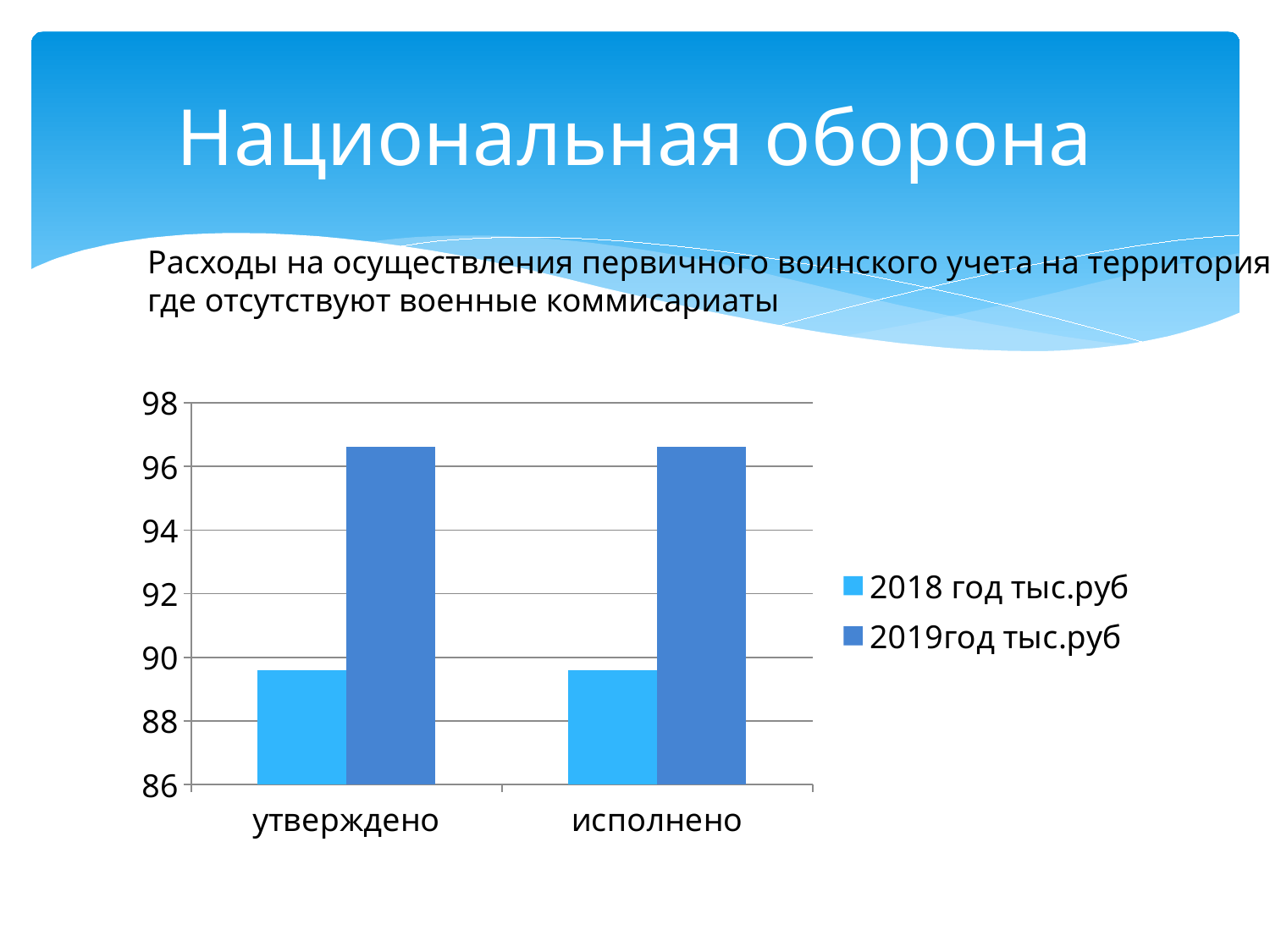
Is the value for 2019год тыс.руб in the category исполнено greater or less than 98? less What kind of chart is shown on the slide? bar chart What are the two series listed in the chart's legend? 2018 год тыс.руб and 2019год тыс.руб Which series is shown in the darker blue bars? 2019год тыс.руб Is the value for 2018 год тыс.руб in the category утверждено greater or less than 92? less For the category исполнено, which series has the larger value: 2018 год тыс.руб or 2019год тыс.руб? 2019год тыс.руб What are the two categories on the x axis of the chart? утверждено and исполнено Is the value for 2019год тыс.руб in the category утверждено greater or less than 94? greater How many series does the chart's legend list? 2 How many categories are shown on the x axis of the chart? 2 For the category утверждено, which series has the larger value: 2018 год тыс.руб or 2019год тыс.руб? 2019год тыс.руб